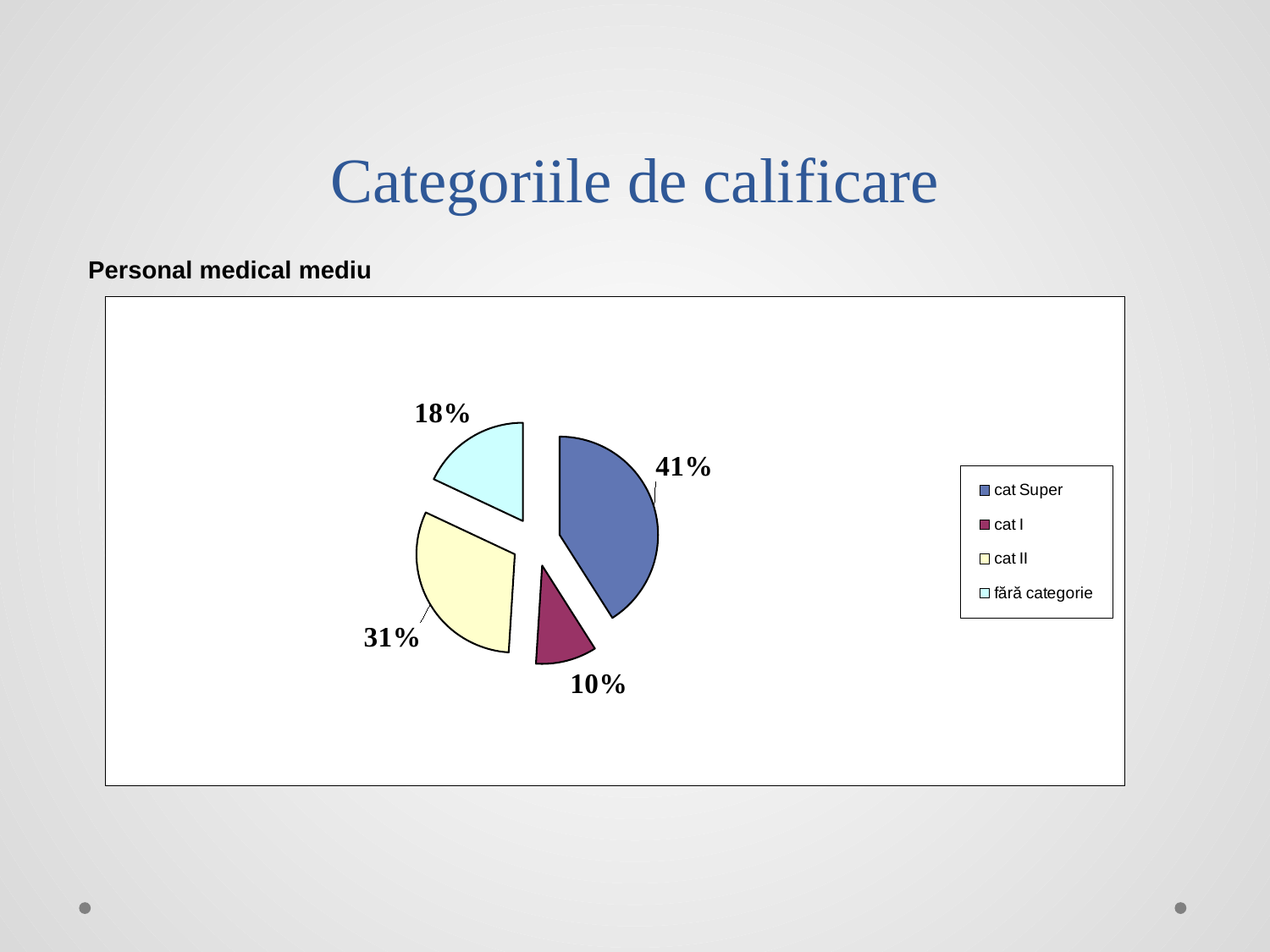
What is the heading text above the chart? Personal medical mediu What share of the pie does cat I have? 10% What is the difference in percentage points between cat Super and cat II? 10% What kind of chart is shown on the slide? pie chart What share of the pie does cat II have? 31% How many entries does the legend list? 4 Which category has the smallest slice of the pie? cat I What share of the pie does fără categorie have? 18% Which is larger, the share for cat II or the share for fără categorie? cat II How many slices does the pie chart have? 4 Which category has the largest slice of the pie? cat Super